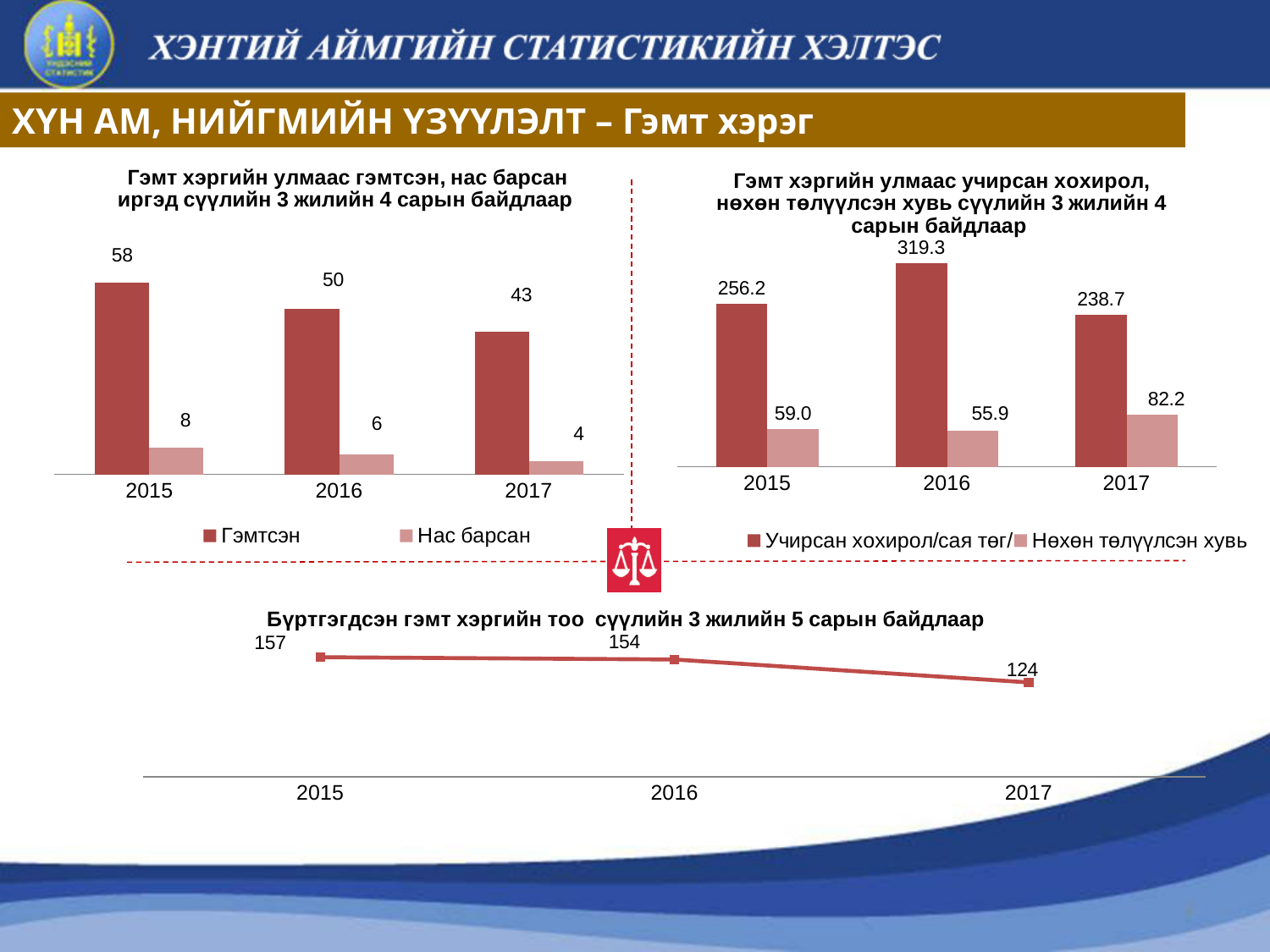
In the top-right chart (Гэмт хэргийн улмаас учирсан хохирол, нөхөн төлүүлсэн хувь), what is the value for Учирсан хохирол/сая төг in 2016? 319.3 What kind of chart is the bottom chart (Бүртгэгдсэн гэмт хэргийн тоо)? line chart In the top-left chart (Гэмт хэргийн улмаас гэмтсэн, нас барсан иргэд), what is the difference between the Гэмтсэн values for 2015 and 2017? 15 In the top-left chart (Гэмт хэргийн улмаас гэмтсэн, нас барсан иргэд), how many series does the legend list? 2 In the top-left chart (Гэмт хэргийн улмаас гэмтсэн, нас барсан иргэд), do the Гэмтсэн values rise or fall from 2015 to 2017? fall In the top-right chart (Гэмт хэргийн улмаас учирсан хохирол, нөхөн төлүүлсэн хувь), which year has the highest Нөхөн төлүүлсэн хувь? 2017 In the top-right chart (Гэмт хэргийн улмаас учирсан хохирол, нөхөн төлүүлсэн хувь), which year has the lowest Учирсан хохирол/сая төг? 2017 In the bottom chart (Бүртгэгдсэн гэмт хэргийн тоо), how many data points are plotted? 3 In the top-left chart (Гэмт хэргийн улмаас гэмтсэн, нас барсан иргэд), what is the value for Нас барсан in 2017? 4 In the top-left chart (Гэмт хэргийн улмаас гэмтсэн, нас барсан иргэд), what is the value for Гэмтсэн in 2015? 58 In the top-right chart (Гэмт хэргийн улмаас учирсан хохирол, нөхөн төлүүлсэн хувь), what is the difference between the Нөхөн төлүүлсэн хувь values for 2017 and 2016? 26.3 In the bottom chart (Бүртгэгдсэн гэмт хэргийн тоо), what is the value for 2017? 124